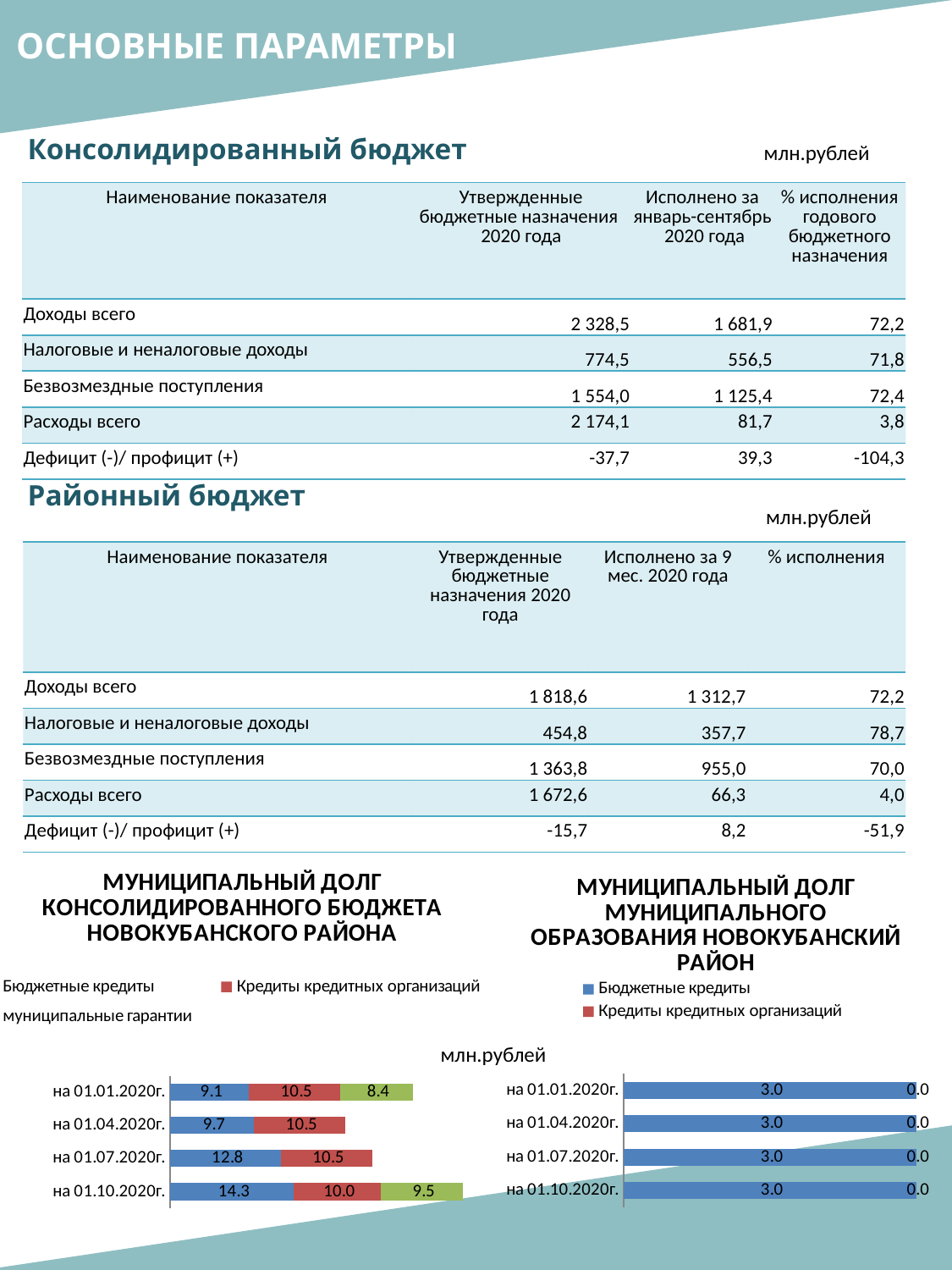
In the chart titled 'МУНИЦИПАЛЬНЫЙ ДОЛГ КОНСОЛИДИРОВАННОГО БЮДЖЕТА НОВОКУБАНСКОГО РАЙОНА', what is the value of 'Бюджетные кредиты' for 'на 01.10.2020г.'? 14.3 In the chart titled 'МУНИЦИПАЛЬНЫЙ ДОЛГ МУНИЦИПАЛЬНОГО ОБРАЗОВАНИЯ НОВОКУБАНСКИЙ РАЙОН', how many dates are shown? 4 In the chart titled 'МУНИЦИПАЛЬНЫЙ ДОЛГ КОНСОЛИДИРОВАННОГО БЮДЖЕТА НОВОКУБАНСКОГО РАЙОНА', which date has the highest value of 'Бюджетные кредиты'? на 01.10.2020г. In the chart titled 'МУНИЦИПАЛЬНЫЙ ДОЛГ КОНСОЛИДИРОВАННОГО БЮДЖЕТА НОВОКУБАНСКОГО РАЙОНА', what is the total of the stacked bar for 'на 01.10.2020г.'? 33.8 In the chart titled 'МУНИЦИПАЛЬНЫЙ ДОЛГ МУНИЦИПАЛЬНОГО ОБРАЗОВАНИЯ НОВОКУБАНСКИЙ РАЙОН', what is the value of 'Бюджетные кредиты' for 'на 01.07.2020г.'? 3.0 In the chart titled 'МУНИЦИПАЛЬНЫЙ ДОЛГ КОНСОЛИДИРОВАННОГО БЮДЖЕТА НОВОКУБАНСКОГО РАЙОНА', how many series does the legend list? 3 In the chart titled 'МУНИЦИПАЛЬНЫЙ ДОЛГ КОНСОЛИДИРОВАННОГО БЮДЖЕТА НОВОКУБАНСКОГО РАЙОНА', what is the value of 'Кредиты кредитных организаций' for 'на 01.01.2020г.'? 10.5 In the chart titled 'МУНИЦИПАЛЬНЫЙ ДОЛГ КОНСОЛИДИРОВАННОГО БЮДЖЕТА НОВОКУБАНСКОГО РАЙОНА', what is the difference between 'Бюджетные кредиты' for 'на 01.10.2020г.' and 'на 01.01.2020г.'? 5.2 In the chart titled 'МУНИЦИПАЛЬНЫЙ ДОЛГ КОНСОЛИДИРОВАННОГО БЮДЖЕТА НОВОКУБАНСКОГО РАЙОНА', what is the value of 'муниципальные гарантии' for 'на 01.10.2020г.'? 9.5 In the chart titled 'МУНИЦИПАЛЬНЫЙ ДОЛГ КОНСОЛИДИРОВАННОГО БЮДЖЕТА НОВОКУБАНСКОГО РАЙОНА', what is the total of the stacked bar for 'на 01.01.2020г.'? 28.0 What kind of chart is the one titled 'МУНИЦИПАЛЬНЫЙ ДОЛГ МУНИЦИПАЛЬНОГО ОБРАЗОВАНИЯ НОВОКУБАНСКИЙ РАЙОН'? Bar chart In the chart titled 'МУНИЦИПАЛЬНЫЙ ДОЛГ КОНСОЛИДИРОВАННОГО БЮДЖЕТА НОВОКУБАНСКОГО РАЙОНА', which date has the lowest value of 'Бюджетные кредиты'? на 01.01.2020г.